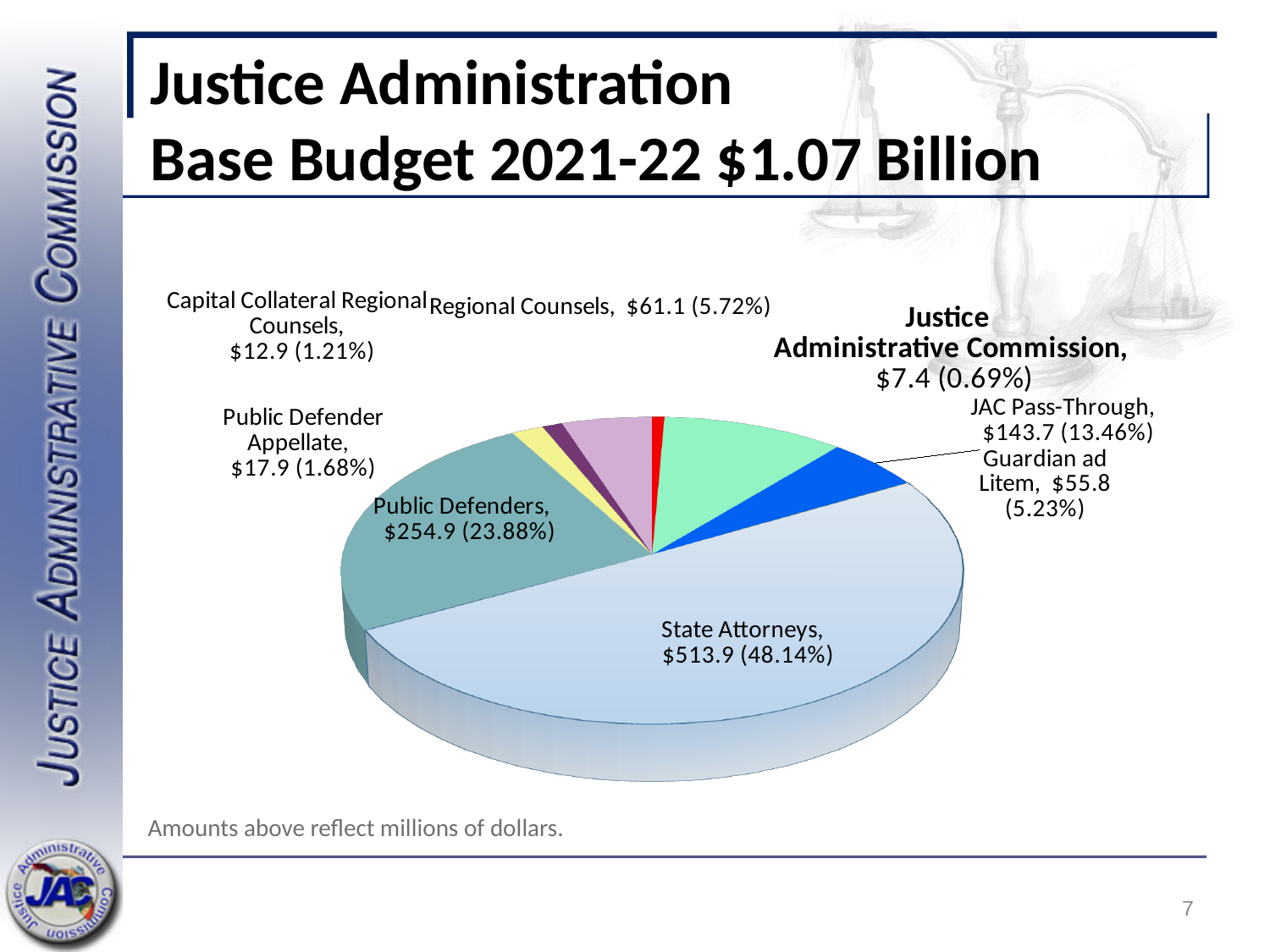
What kind of chart is shown on the slide? Pie chart What is the value shown for State Attorneys? $513.9 (48.14%) What is the value shown for Guardian ad Litem? $55.8 (5.23%) Which is larger, Public Defender Appellate or Capital Collateral Regional Counsels? Public Defender Appellate According to the note below the chart, what unit are the amounts in? Millions of dollars What is the value shown for Public Defenders? $254.9 (23.88%) What percentage share of the pie does Regional Counsels represent? 5.72% What is the difference in dollars between State Attorneys and Public Defenders? $259.0 What is the value shown for JAC Pass-Through? $143.7 (13.46%) How many categories are shown in the pie chart? 8 Which category has the largest slice of the pie? State Attorneys Which category has the smallest slice of the pie? Justice Administrative Commission